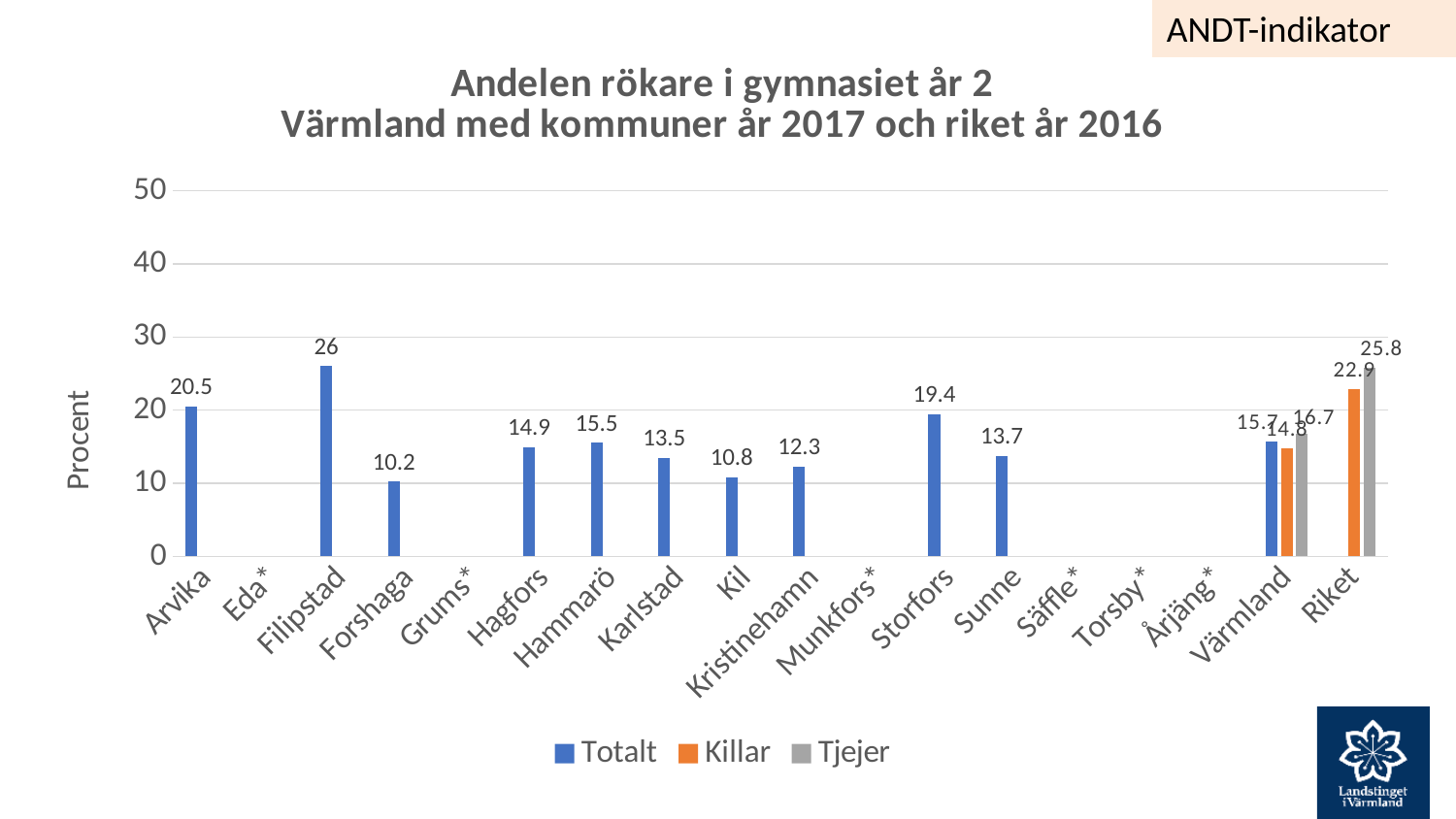
What is the difference between the Totalt values for Arvika and Storfors? 1.1 What is the Totalt value for Filipstad? 26 What is the Totalt value for Kristinehamn? 12.3 What is the difference between the Tjejer and Killar values for Riket? 2.9 How many categories are shown on the x axis? 18 How many series does the legend list? 3 What is the Tjejer value for Riket? 25.8 Which municipality has the highest Totalt value? Filipstad What kind of chart is shown on the slide? Bar chart Which has the higher Totalt value, Hagfors or Hammarö? Hammarö What is the Killar value for Värmland? 14.8 Which municipality has the lowest Totalt value among those with a bar shown? Forshaga